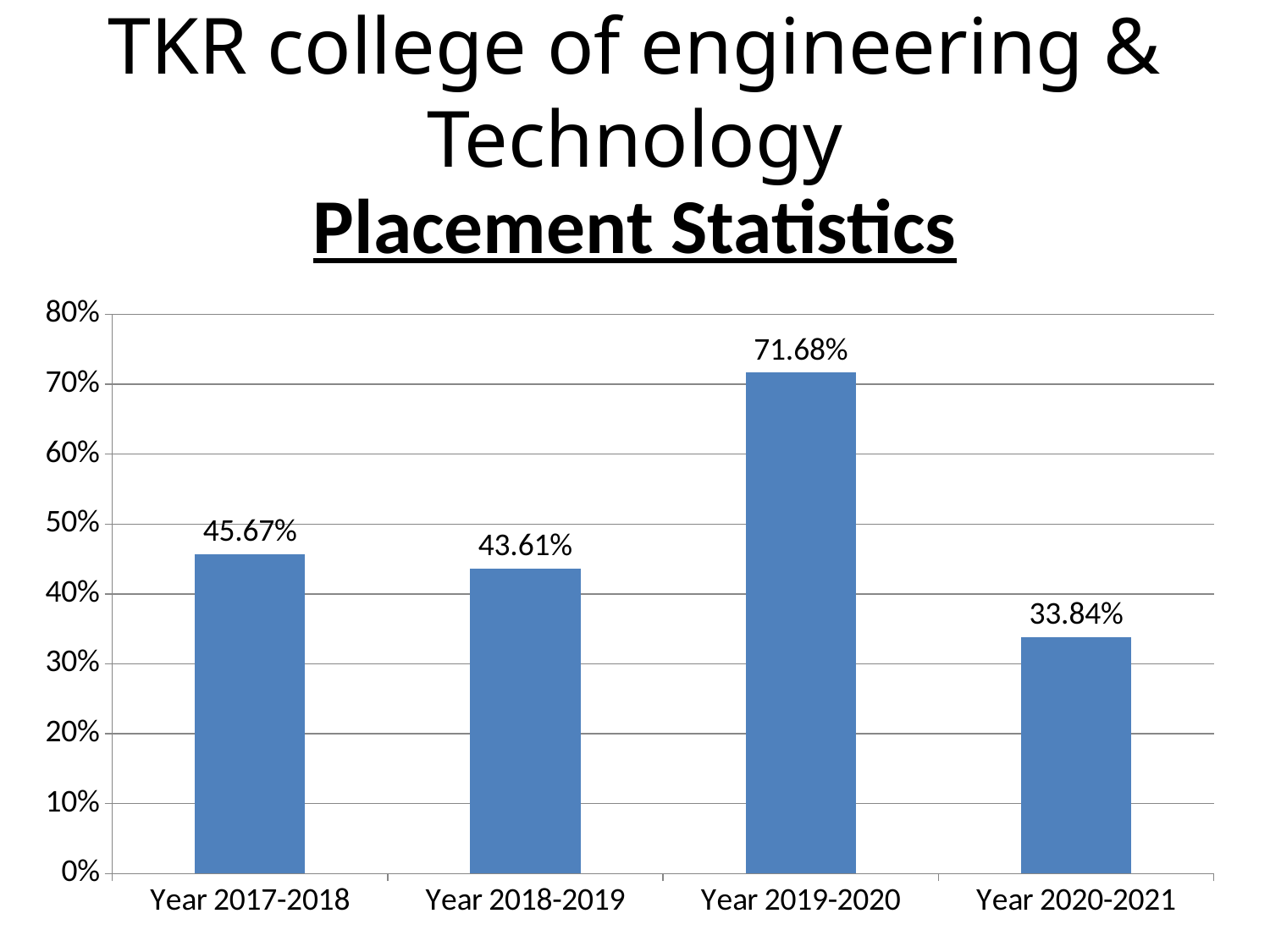
What is the difference in placement percentage between Year 2017-2018 and Year 2018-2019? 2.06% What is the placement percentage for Year 2019-2020? 71.68% What is the placement percentage for Year 2018-2019? 43.61% What kind of chart is shown on the slide? Bar chart Which year has the highest placement percentage? Year 2019-2020 Is the value for Year 2019-2020 greater or less than 70%? greater Which year has the lowest placement percentage? Year 2020-2021 What is the difference in placement percentage between Year 2019-2020 and Year 2020-2021? 37.84% How many years are shown on the chart? 4 What is the placement percentage for Year 2017-2018? 45.67% Which is larger, the placement percentage for Year 2017-2018 or Year 2020-2021? Year 2017-2018 What is the placement percentage for Year 2020-2021? 33.84%